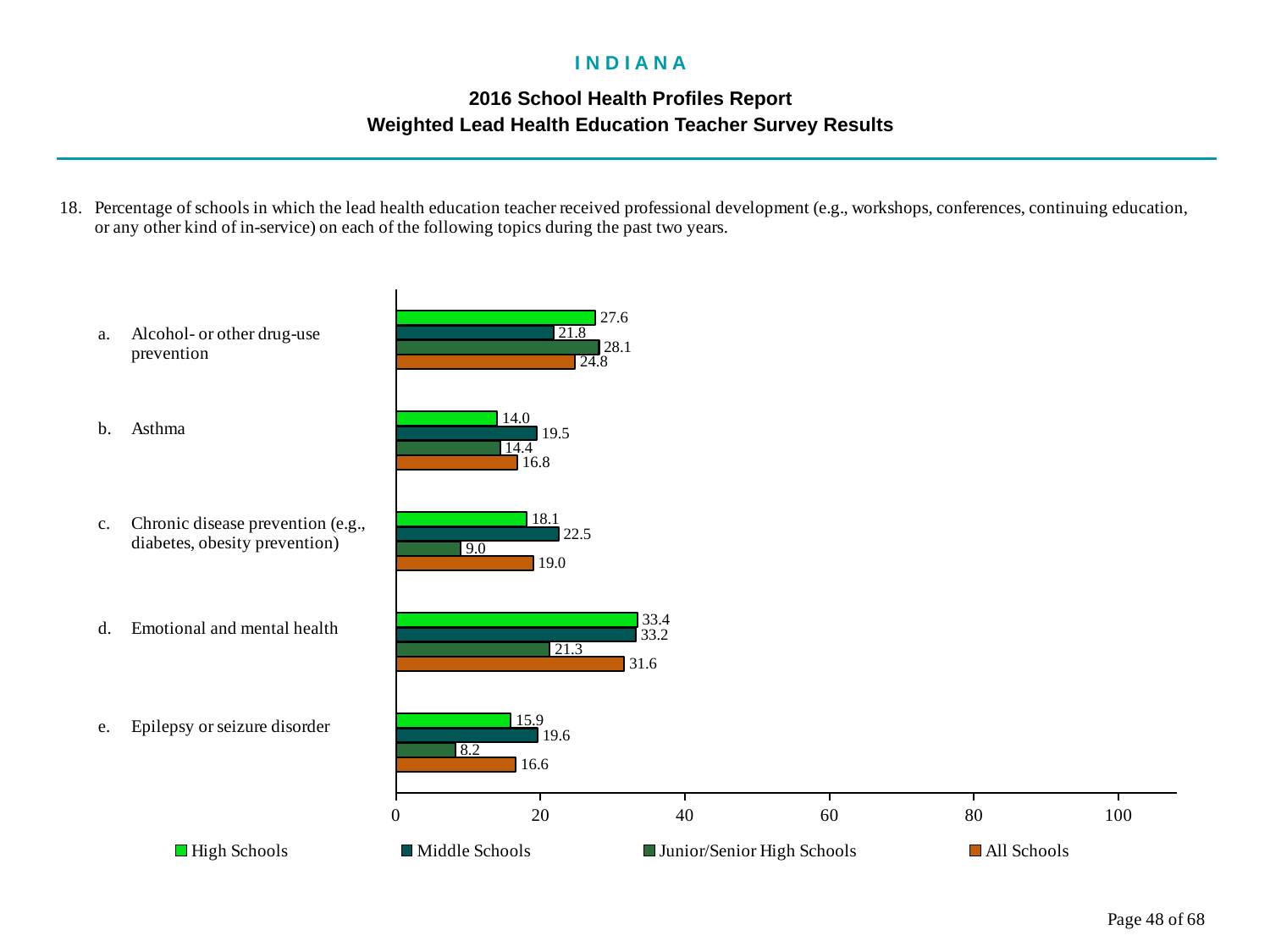
What is the value for Middle Schools for Chronic disease prevention (e.g., diabetes, obesity prevention)? 22.5 How many topics are shown on the chart? 5 How many series does the legend list? 4 Which topic has the highest value for All Schools? Emotional and mental health What is the difference between the High Schools and Junior/Senior High Schools values for Emotional and mental health? 12.1 Which topic has the lowest value for Junior/Senior High Schools? Epilepsy or seizure disorder Which series is shown in orange in the legend? All Schools What is the value for All Schools for Asthma? 16.8 What kind of chart is shown on the slide? Bar chart What is the value for High Schools for Emotional and mental health? 33.4 What is the value for Junior/Senior High Schools for Epilepsy or seizure disorder? 8.2 Which is larger for Asthma: the Middle Schools value or the High Schools value? Middle Schools